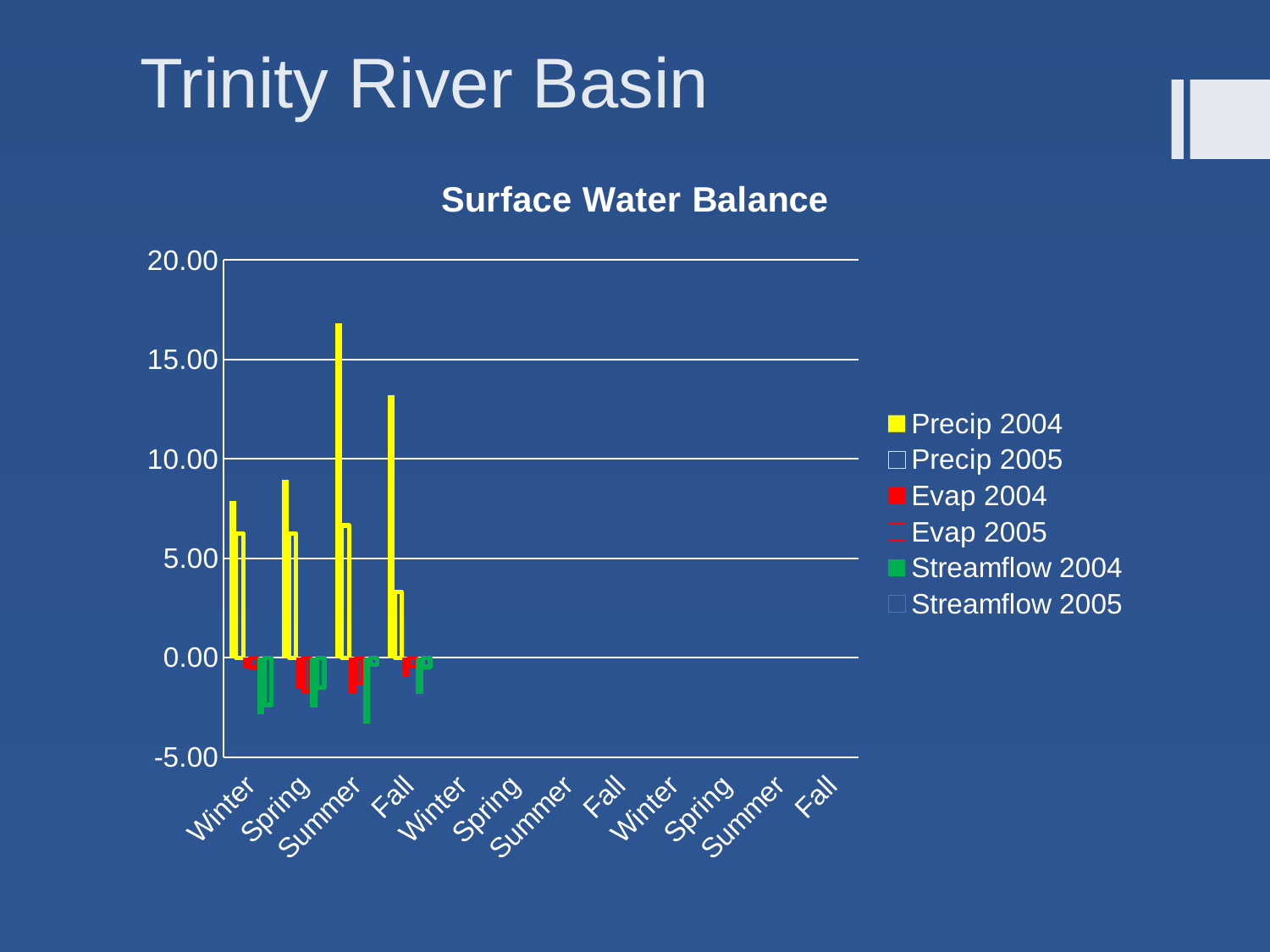
Which season has the highest Precip 2004 value? Summer Which is larger, the Precip 2004 value for Summer or for Fall? Summer Is the Precip 2004 value for Spring greater or less than 10.00? less Which legend entry is shown in green? Streamflow 2004 What is the title of the chart? Surface Water Balance Is the Precip 2004 value for Summer greater or less than 15.00? greater Is the Precip 2004 value for Fall greater or less than 10.00? greater Which season has the lowest Precip 2005 value? Fall How many category labels are shown along the x axis? 12 How many series does the legend list? 6 What kind of chart is shown on the slide? bar chart